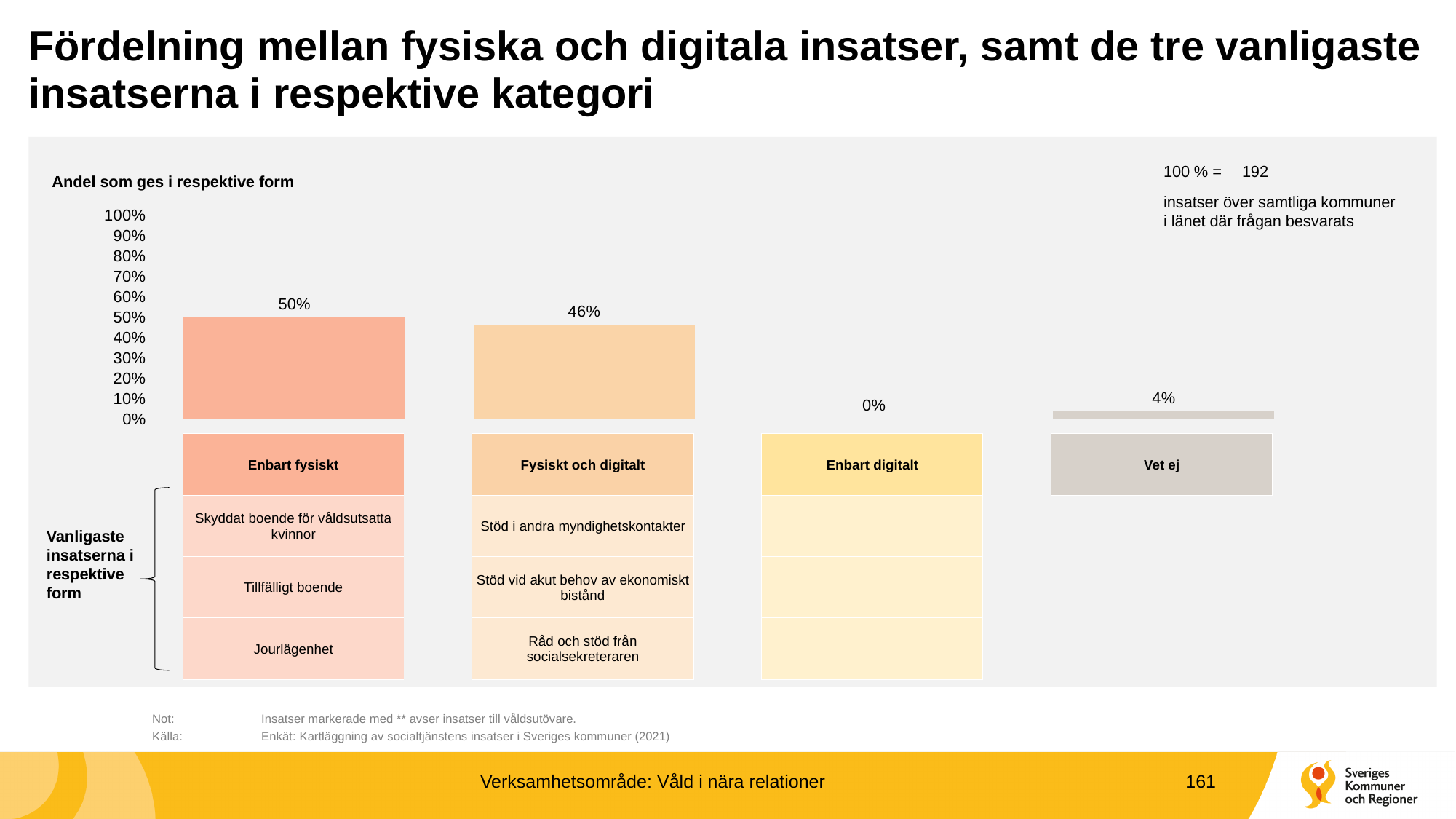
What is the value for "Enbart digitalt"? 0% Which category has the highest value? Enbart fysiskt How many categories are shown in the bar chart? 4 What kind of chart is shown on the slide? Bar chart What is the value for "Enbart fysiskt" in the chart "Andel som ges i respektive form"? 50% What is the title of the chart? Andel som ges i respektive form What is the difference between the values for "Enbart fysiskt" and "Fysiskt och digitalt"? 4 percentage points What is the value for "Vet ej"? 4% What is the value for "Fysiskt och digitalt"? 46% According to the slide, how many insatser does 100 % correspond to? 192 Which category has the lowest value? Enbart digitalt Which is larger, the value for "Vet ej" or the value for "Enbart digitalt"? Vet ej